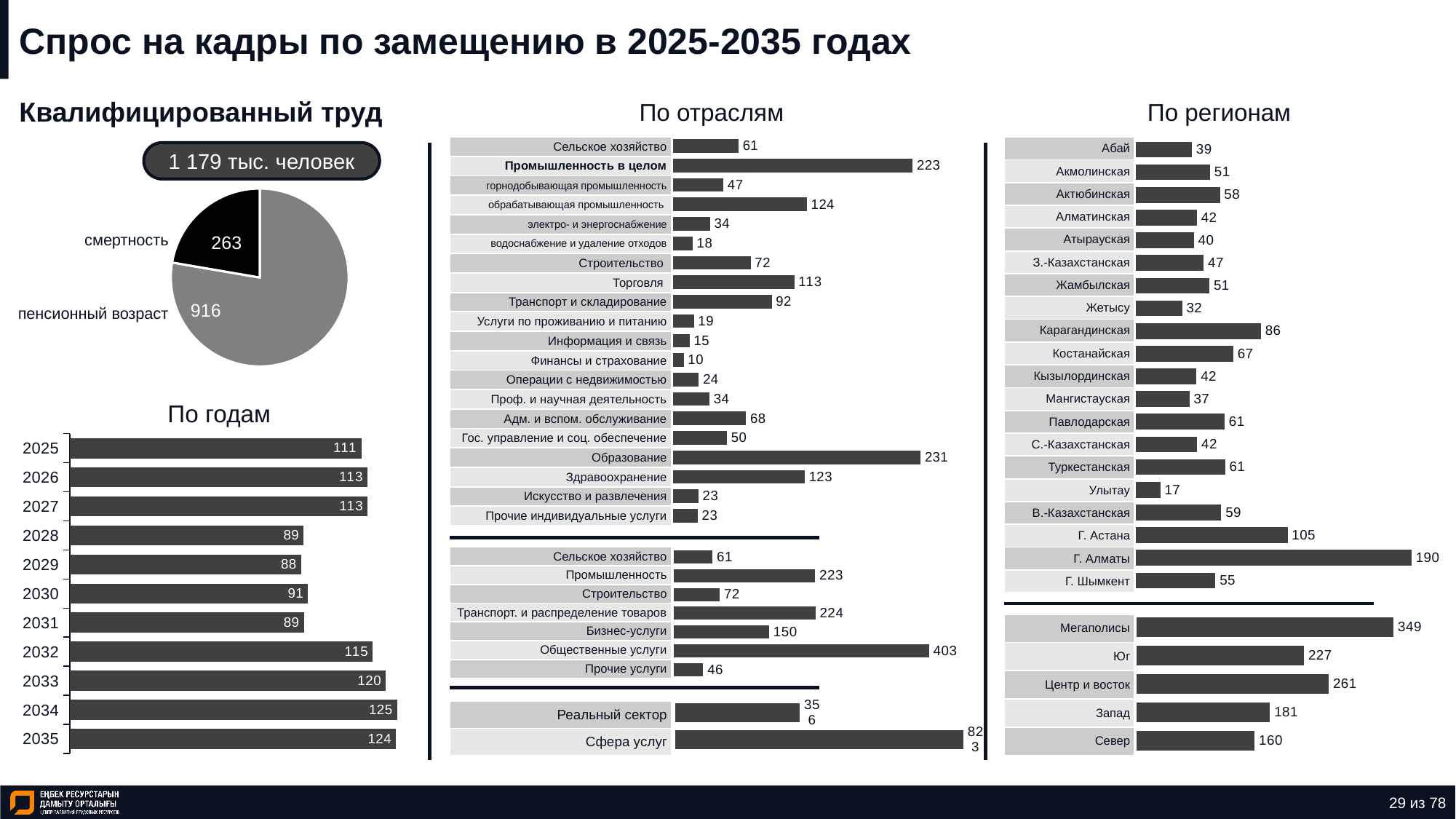
In the 'По отраслям' chart, what is the value for Торговля? 113 How many years are shown in the 'По годам' chart? 11 In the 'По регионам' chart, what is the difference between Г. Алматы and Г. Астана? 85 In the 'По годам' chart, what is the value for 2033? 120 In the 'Квалифицированный труд' pie chart, what is the value for смертность? 263 In the 'По регионам' chart, which region has the highest value? Г. Алматы In the 'По отраслям' chart, what is the difference between Образование and Здравоохранение? 108 In the 'По годам' chart, which year has the highest value? 2034 In the 'По отраслям' chart, which industry in the top section has the highest value? Образование In the 'По годам' chart, which year has the lowest value? 2029 In the 'По регионам' chart, which is larger: Юг or Центр и восток? Центр и восток In the 'По отраслям' chart, which industry in the top section has the lowest value? Финансы и страхование